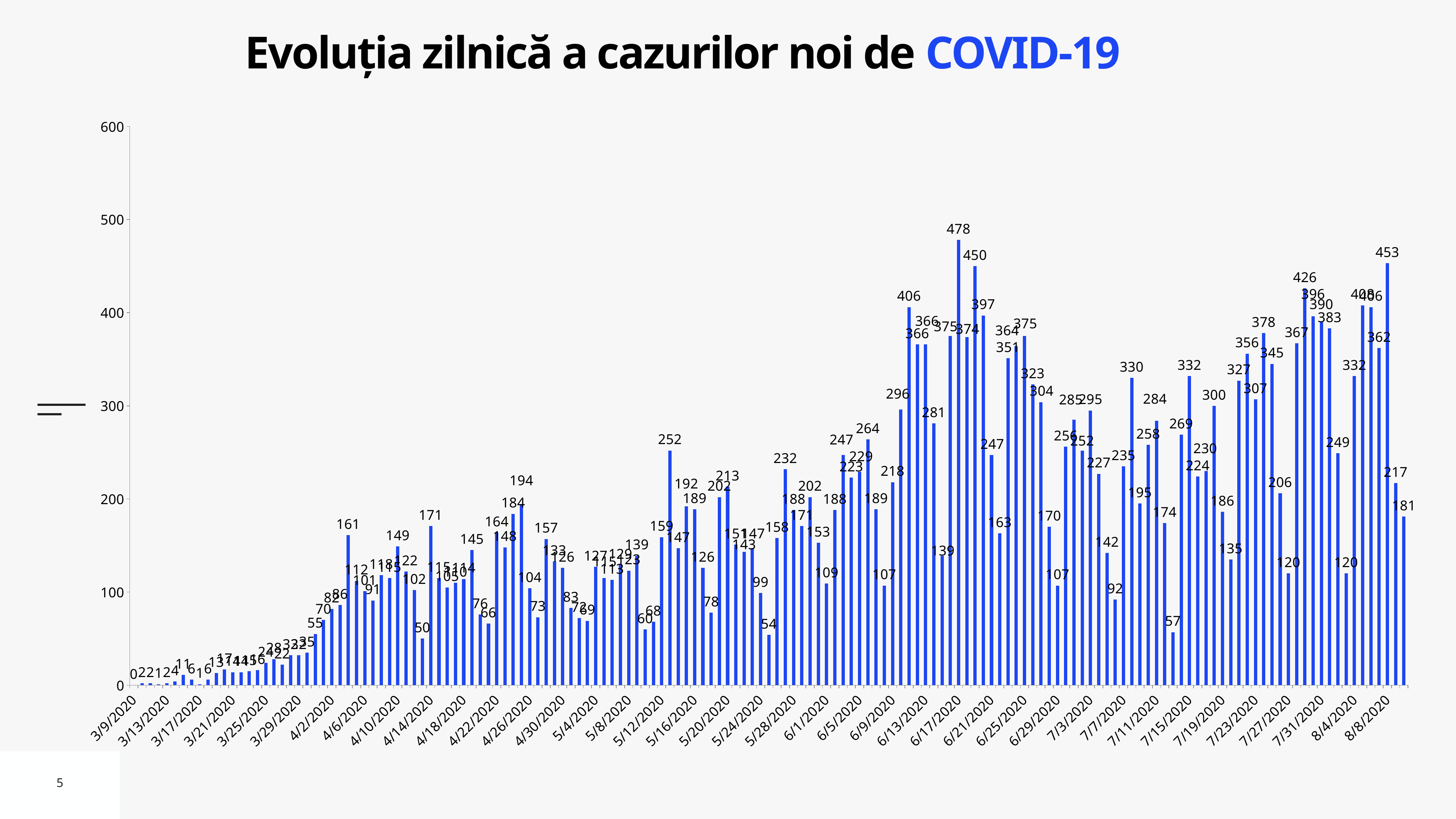
Is the highest bar in the chart greater or less than 500? less What is the value of the first bar, for 3/9/2020? 0 Which is larger, the bar labelled 478 or the bar labelled 453? 478 What is the difference between the last two bars, labelled 217 and 181? 36 Is the rightmost bar greater or less than 200? less What is the title of the chart? Evoluția zilnică a cazurilor noi de COVID-19 Overall, do the daily values rise or fall from March to August along the x axis? rise What is the highest daily value shown in the chart? 478 What is the highest value shown on the vertical axis? 600 What is the value of the last (rightmost) bar in the chart? 181 What kind of chart is shown on the slide? bar chart